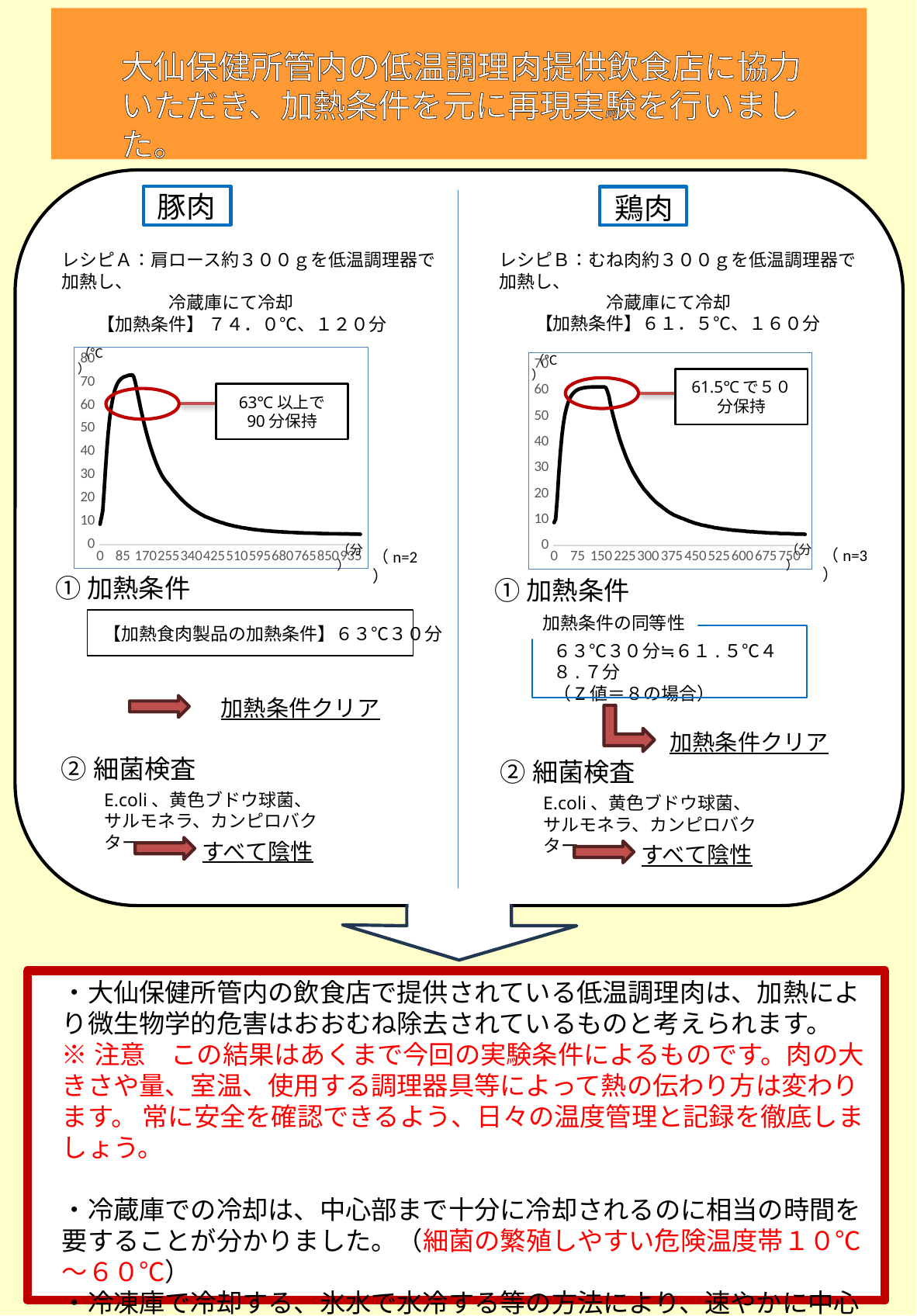
How many lines are plotted on the 豚肉 (pork) chart? 1 What is the highest tick value on the y axis of the 豚肉 (pork) chart? 80 What is the last tick value on the x axis of the 鶏肉 (chicken) chart? 750 On the 豚肉 (pork) chart, is the peak temperature greater or less than 60? greater What kind of chart is the 鶏肉 (chicken) chart on the right? line chart On the 豚肉 (pork) chart, does the temperature rise or fall after reaching its peak? fall On the 鶏肉 (chicken) chart, is the temperature at the final time point (750) greater or less than 10? less On the 鶏肉 (chicken) chart, does the temperature rise or fall between time 0 and time 75? rise On the 鶏肉 (chicken) chart, is the peak temperature greater or less than 70? less How many lines are plotted on the 鶏肉 (chicken) chart? 1 What kind of chart is the 豚肉 (pork) chart on the left? line chart